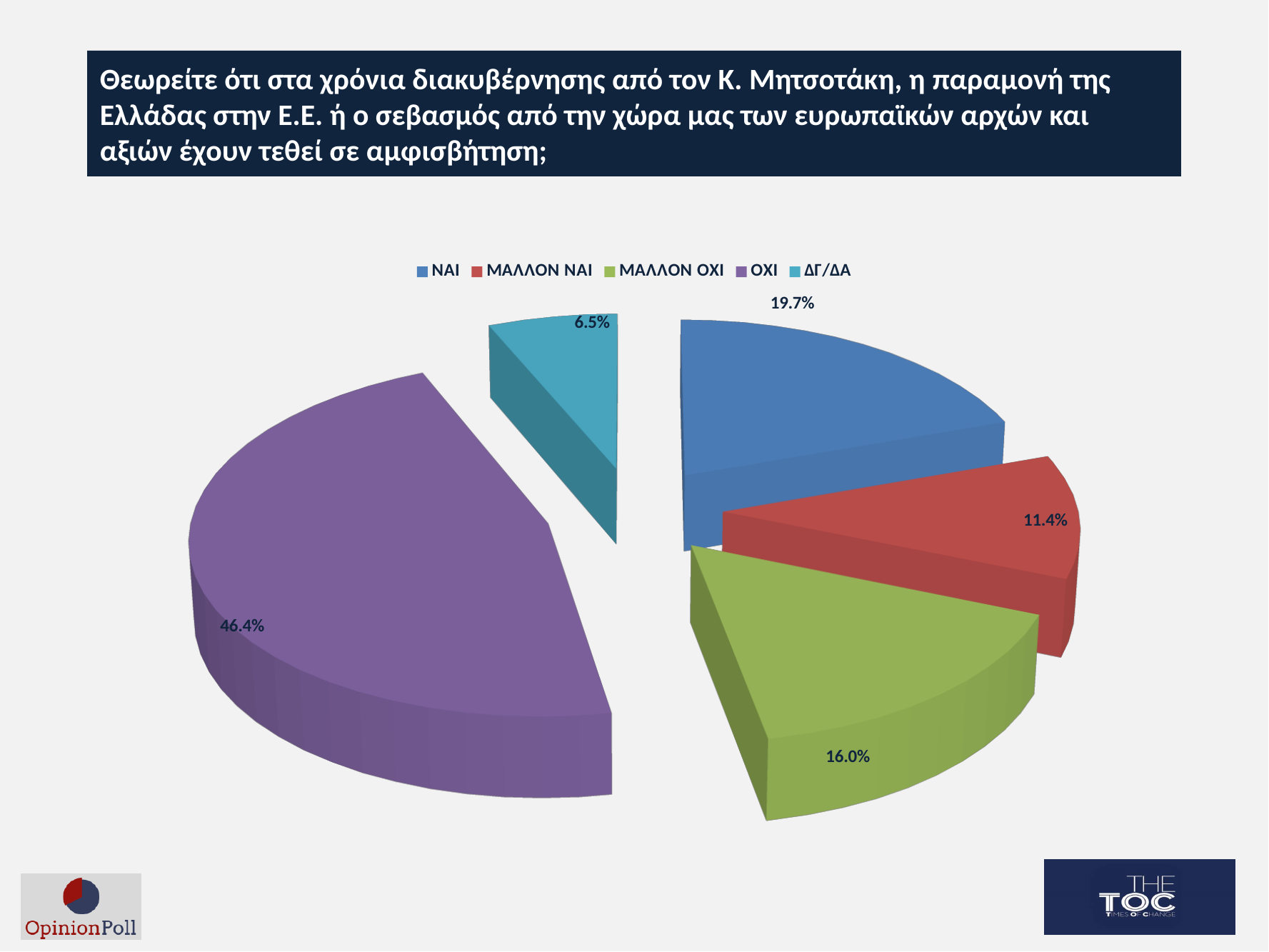
Which response has the smallest share of the pie? ΔΓ/ΔΑ What percentage of respondents answered ΔΓ/ΔΑ? 6.5% Which response has the largest share of the pie? ΟΧΙ What percentage of respondents answered ΜΑΛΛΟΝ ΟΧΙ? 16.0% Which is larger, the share for ΜΑΛΛΟΝ ΝΑΙ or the share for ΜΑΛΛΟΝ ΟΧΙ? ΜΑΛΛΟΝ ΟΧΙ What percentage of respondents answered ΝΑΙ? 19.7% What percentage of respondents answered ΟΧΙ? 46.4% What colour is the slice for ΟΧΙ? Purple What is the combined share of ΝΑΙ and ΜΑΛΛΟΝ ΝΑΙ? 31.1% What is the difference in percentage points between ΟΧΙ and ΝΑΙ? 26.7 What type of chart is shown on the slide? Pie chart How many slices does the pie chart have? 5